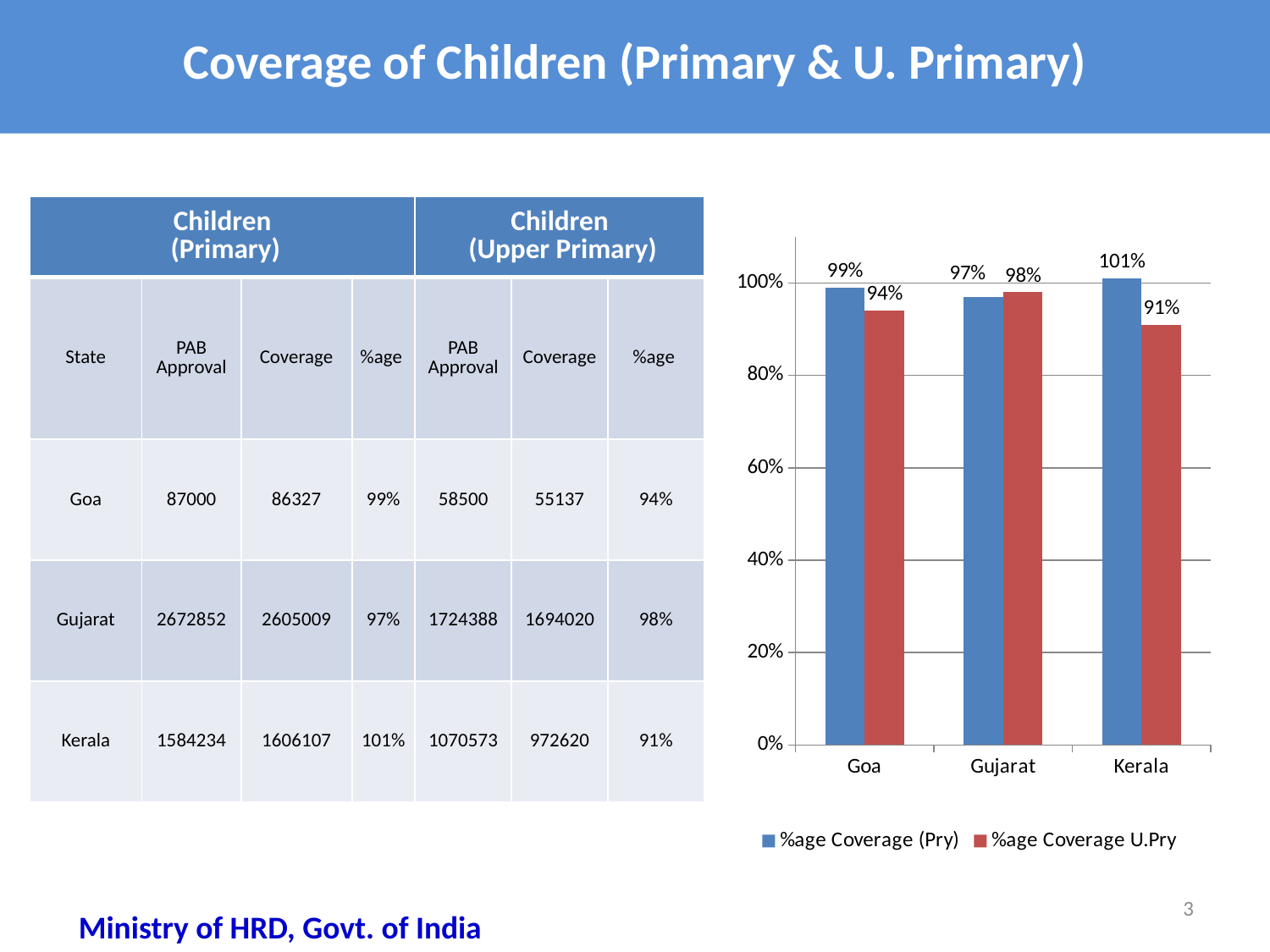
Which state has the lowest %age Coverage U.Pry in the chart? Kerala Which is larger for Goa: %age Coverage (Pry) or %age Coverage U.Pry? %age Coverage (Pry) What is the %age Coverage (Pry) value for Goa in the chart? 99% What kind of chart is shown on the slide? Bar chart What is the %age Coverage U.Pry value for Gujarat in the chart? 98% Which state has the highest %age Coverage (Pry) in the chart? Kerala What is the %age Coverage U.Pry value for Kerala in the chart? 91% How many series does the chart legend list? 2 How many states are shown on the x axis of the chart? 3 What colour are the %age Coverage U.Pry bars in the chart? Red Is the %age Coverage (Pry) value for Kerala greater or less than 100%? greater What is the difference between the %age Coverage (Pry) and %age Coverage U.Pry values for Kerala? 10%